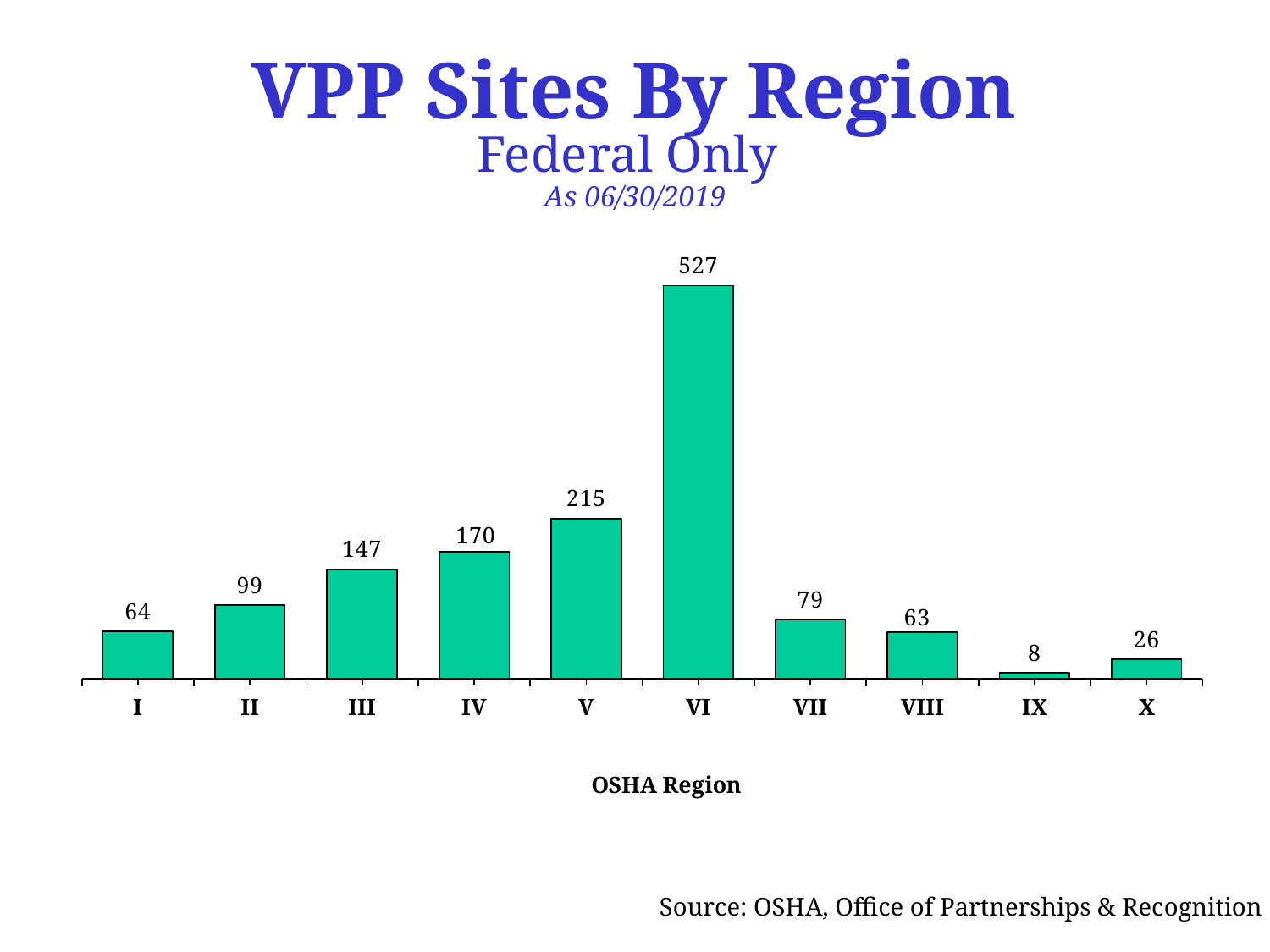
What is the difference between the number of VPP sites in Region VI and Region V? 312 Which has more VPP sites, Region VII or Region VIII? Region VII What is the number of VPP sites in OSHA Region III? 147 What kind of chart is shown on the slide? Bar chart How many OSHA regions are shown on the chart? 10 What is the number of VPP sites in OSHA Region VI? 527 What is the difference between the number of VPP sites in Region V and Region IV? 45 What is the number of VPP sites in OSHA Region X? 26 Which has more VPP sites, Region I or Region II? Region II What is the x-axis title of the chart? OSHA Region Which OSHA region has the highest number of VPP sites? VI Which OSHA region has the lowest number of VPP sites? IX